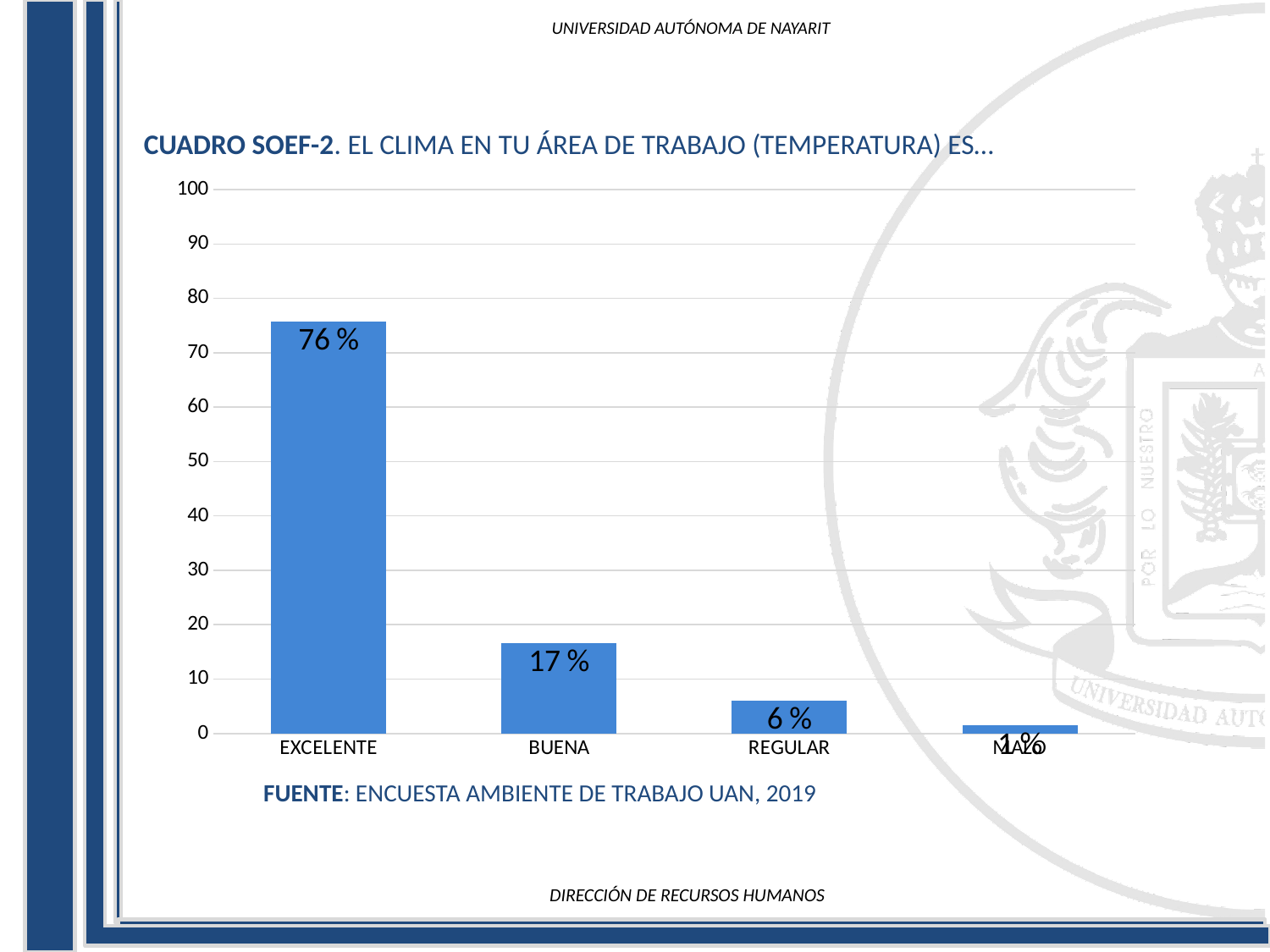
What is the difference between the values for BUENA and REGULAR? 11 % Do the values rise or fall from left to right along the x axis? fall How many categories are shown on the x axis? 4 What is the value for EXCELENTE? 76 % What is the difference between the values for EXCELENTE and BUENA? 59 % Which is larger, the value for BUENA or the value for REGULAR? BUENA Is the value for EXCELENTE greater or less than 70? greater Which category has the lowest value? MALO Which category has the highest value? EXCELENTE What is the value for REGULAR? 6 % What is the value for BUENA? 17 % What kind of chart is shown on the slide? bar chart